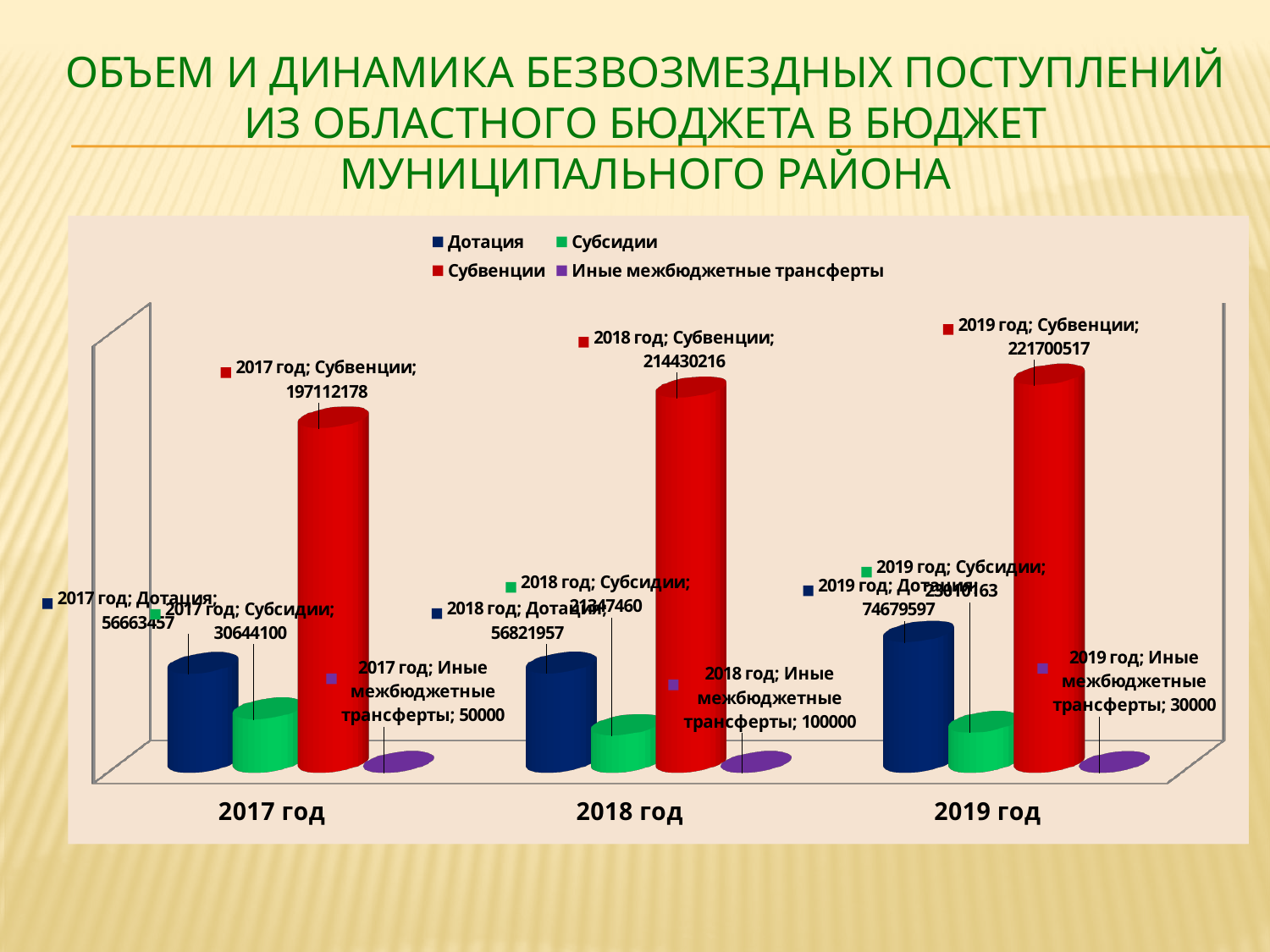
Do the Субвенции values rise or fall from 2017 год to 2019 год? rise In which year is the value of Субвенции the highest? 2019 год In which year is the value of Иные межбюджетные трансферты the lowest? 2019 год What is the value of Дотация for 2019 год? 74679597 What is the difference between the Субвенции values for 2019 год and 2018 год? 7270301 What is the value of Субвенции for 2019 год? 221700517 How many series does the legend list? 4 What is the value of Иные межбюджетные трансферты for 2018 год? 100000 What kind of chart is shown on the slide? bar chart What is the value of Субсидии for 2017 год? 30644100 What is the value of Субвенции for 2017 год? 197112178 What is the value of Субвенции for 2018 год? 214430216